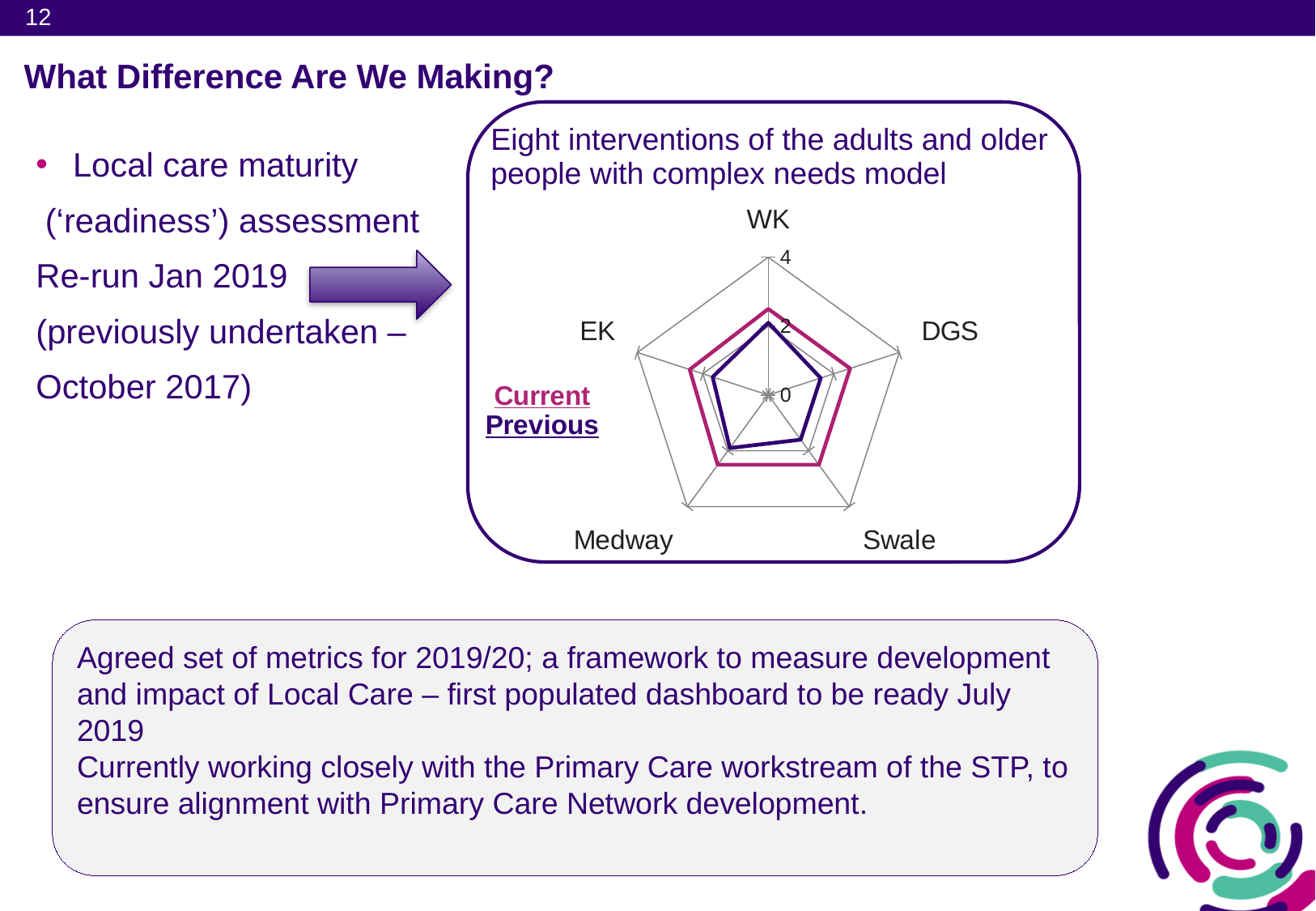
What is the title of the radar chart? Eight interventions of the adults and older people with complex needs model What kind of chart is shown on the slide? radar chart Which series is larger for WK, Current or Previous? Current Which series is larger for DGS, Current or Previous? Current Which series is larger for Medway, Current or Previous? Current How many series does the radar chart's legend list? 2 Is the Current value for EK greater or less than 4? less Is the Current value for WK greater or less than 4? less What are the two series shown in the radar chart? Current and Previous What is the maximum value shown on the radar chart's axis scale? 4 Is the Previous value for Swale greater or less than 4? less How many categories (axes) does the radar chart have? 5